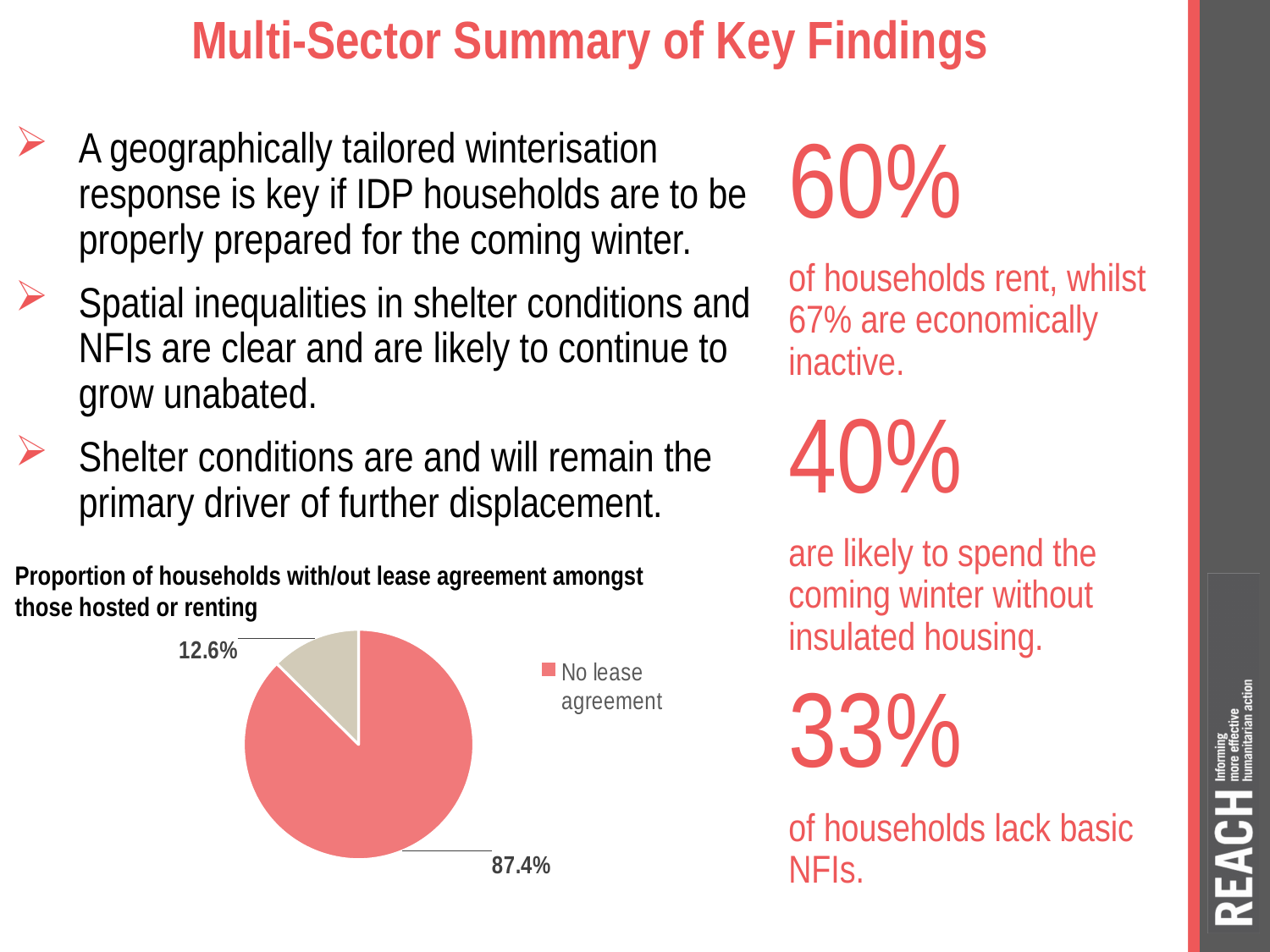
Which slice of the pie chart is the largest? No lease agreement Is the share for "No lease agreement" greater or less than 50%? greater Is the "No lease agreement" slice larger or smaller than the other slice? Larger How many slices does the pie chart have? 2 What colour is the "No lease agreement" slice in the pie chart? Red What is the title of the pie chart? Proportion of households with/out lease agreement amongst those hosted or renting What kind of chart is shown on the slide? Pie chart What is the value shown for the smaller slice of the pie chart? 12.6% What is the difference in percentage points between the two slices of the pie chart? 74.8 What share of the pie is labelled "No lease agreement"? 87.4% How many entries does the pie chart's legend list? 1